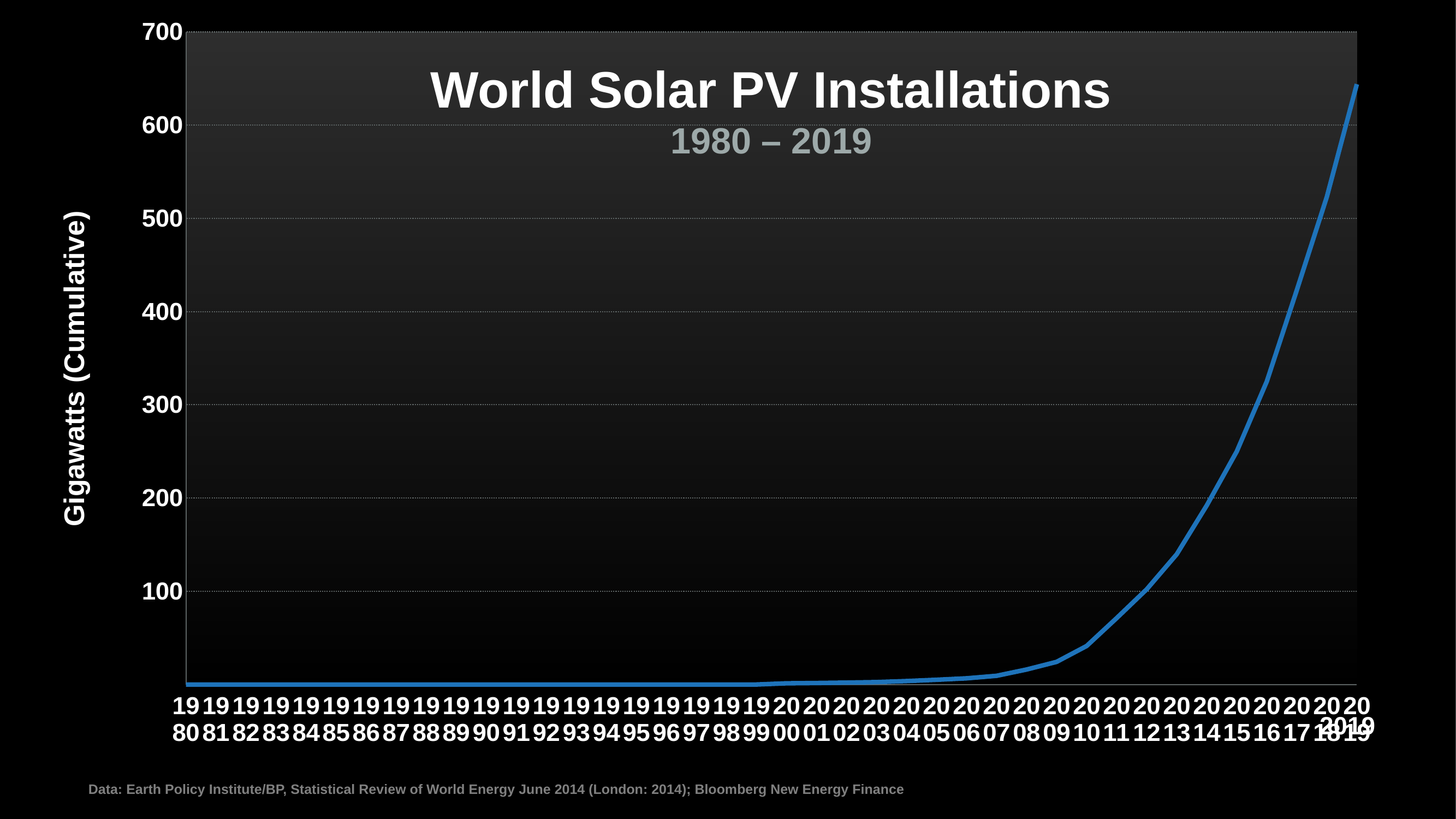
How many years are plotted along the x axis? 40 Is the value for 2019 greater or less than 600? greater Is the value for 2010 greater or less than 100? less What is the title of the chart? World Solar PV Installations Is the value for 2018 greater or less than 400? greater Which year has the larger value, 2005 or 2018? 2018 Do the values rise or fall from 1980 to 2019? rise What is the label on the vertical axis? Gigawatts (Cumulative) Which year has the highest cumulative installations? 2019 What kind of chart is shown on the slide? line chart